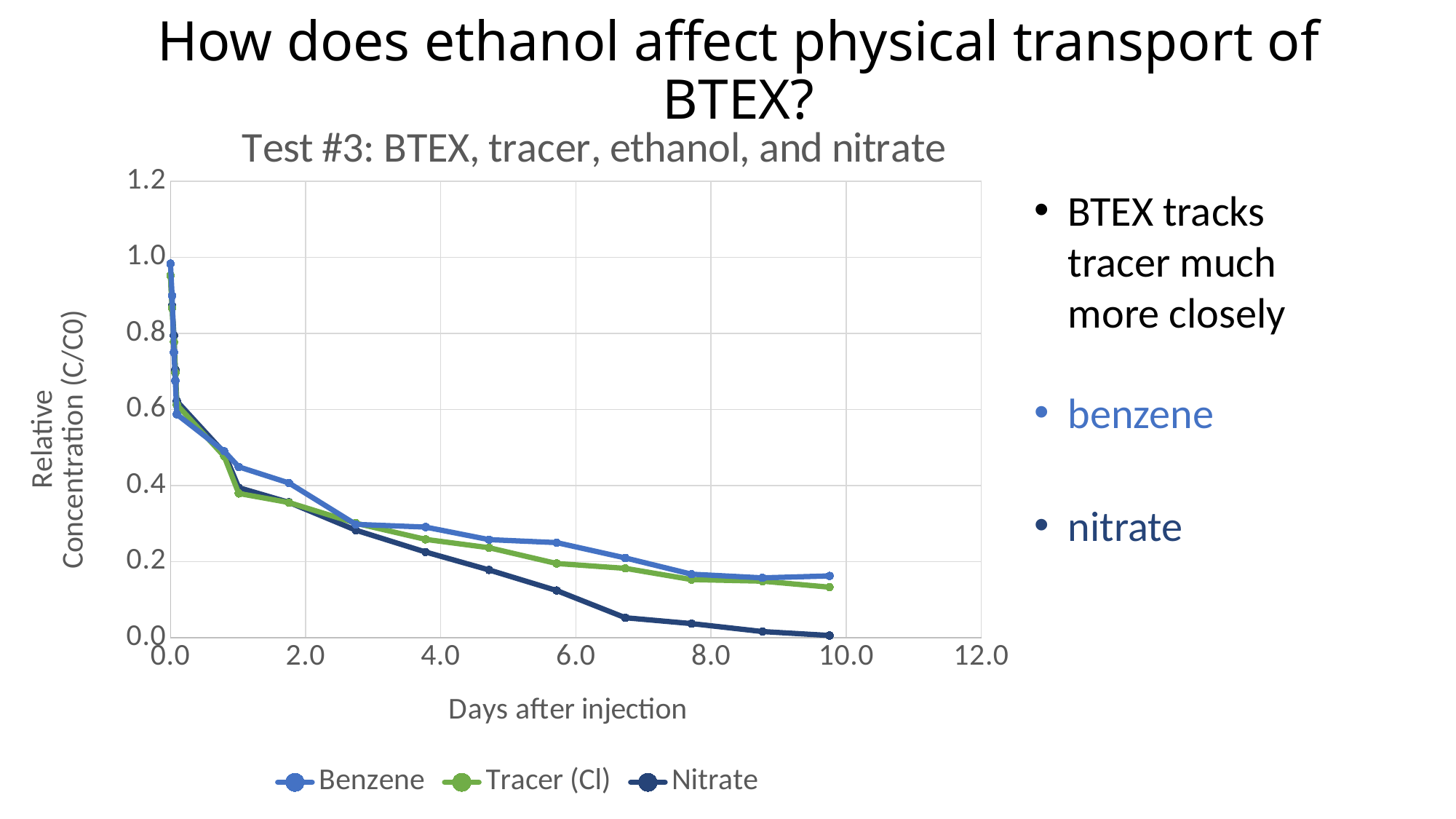
What is the label of the x axis of the chart? Days after injection Do the Nitrate values rise or fall as days after injection increase? fall At about 6 days after injection, which is larger, the Tracer (Cl) value or the Nitrate value? Tracer (Cl) At about 2 days after injection, is the Benzene value greater or less than 0.2? greater At about 10 days after injection, is the Nitrate value greater or less than 0.2? less Which series has the lowest relative concentration at about 10 days after injection? Nitrate How many series does the chart legend list? 3 Do the Benzene values rise or fall as days after injection increase? fall What is the title of the chart? Test #3: BTEX, tracer, ethanol, and nitrate What kind of chart is shown on the slide? line chart At about 10 days after injection, which is larger, the Benzene value or the Nitrate value? Benzene At about 7 days after injection, is the Nitrate value greater or less than 0.2? less